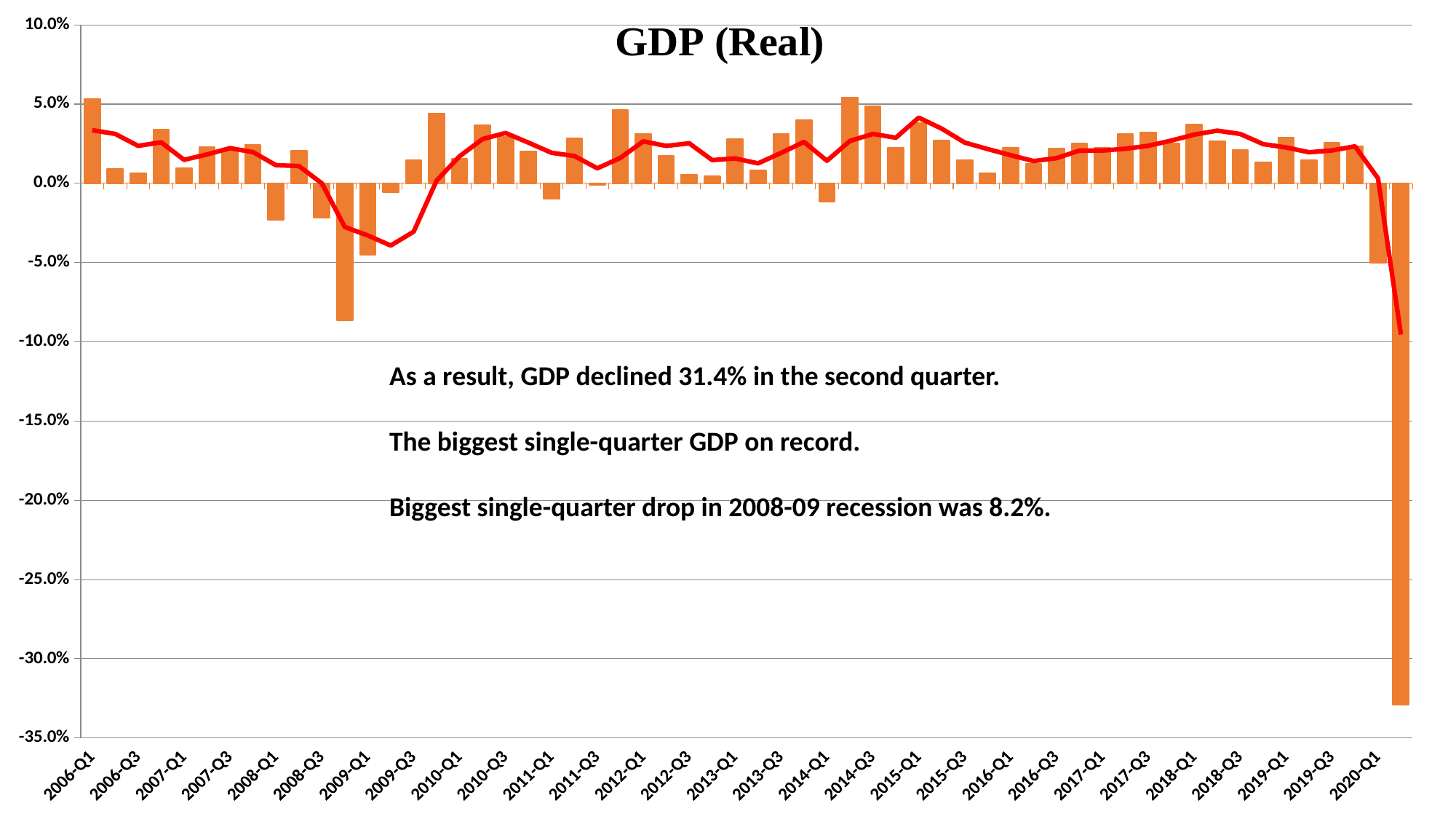
What is the lowest value shown on the vertical axis? -35.0% Which is larger, the value for 2010-Q1 or the value for 2011-Q1? 2010-Q1 Is the value for 2009-Q3 greater or less than 0.0%? greater Is the value for 2008-Q1 greater or less than 0.0%? less Which is larger, the value for 2006-Q1 or the value for 2006-Q3? 2006-Q1 What is the title of the chart? GDP (Real) Do the bar values rise or fall from 2008-Q3 to 2009-Q1? fall Which is larger, the value for 2009-Q1 or the value for 2009-Q3? 2009-Q3 Is the lowest bar on the chart greater or less than -30.0%? less What kind of chart is this? Bar chart with a line overlay